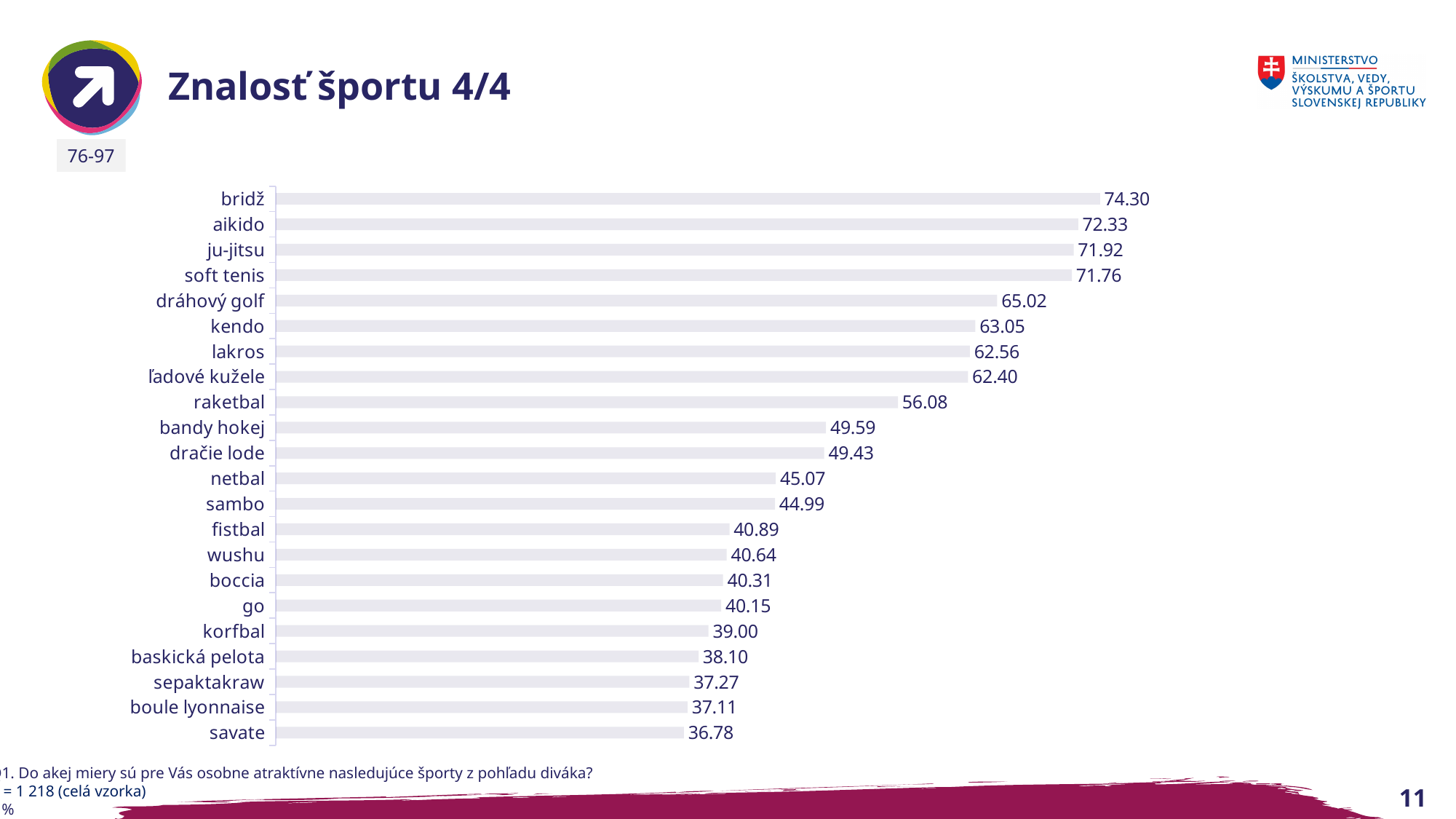
Which category has the lowest value? savate What kind of chart is shown on the slide? bar chart What is the title of the slide? Znalosť športu 4/4 How many categories are shown in the chart? 22 What is the value for dráhový golf? 65.02 What is the difference between the values for bridž and savate? 37.52 Which category has the highest value? bridž Which has a larger value, kendo or netbal? kendo What is the value for raketbal? 56.08 What is the difference between the values for raketbal and bandy hokej? 6.49 What is the value for korfbal? 39.00 What is the value for bridž? 74.30